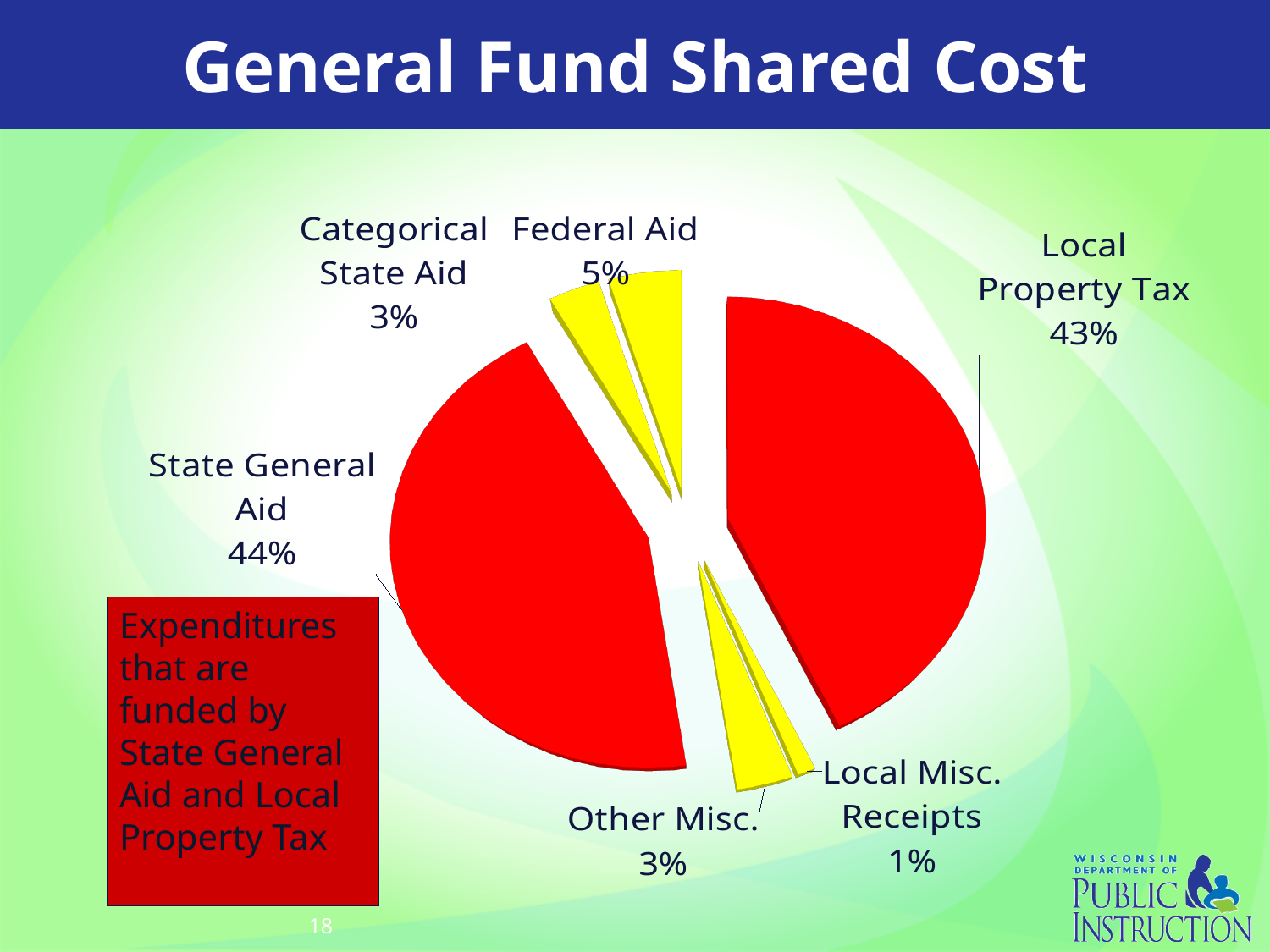
Which slice of the pie is the largest? State General Aid What kind of chart is shown on the slide? pie chart What is the difference in percentage points between Federal Aid and Other Misc.? 2 How many slices does the pie chart have? 6 What is the title of the chart on the slide? General Fund Shared Cost What share of the pie is State General Aid? 44% What share of the pie is Local Property Tax? 43% Which is larger, Federal Aid or Categorical State Aid? Federal Aid What share of the pie is Categorical State Aid? 3% What share of the pie is Local Misc. Receipts? 1% Which slice of the pie is the smallest? Local Misc. Receipts What share of the pie is Federal Aid? 5%